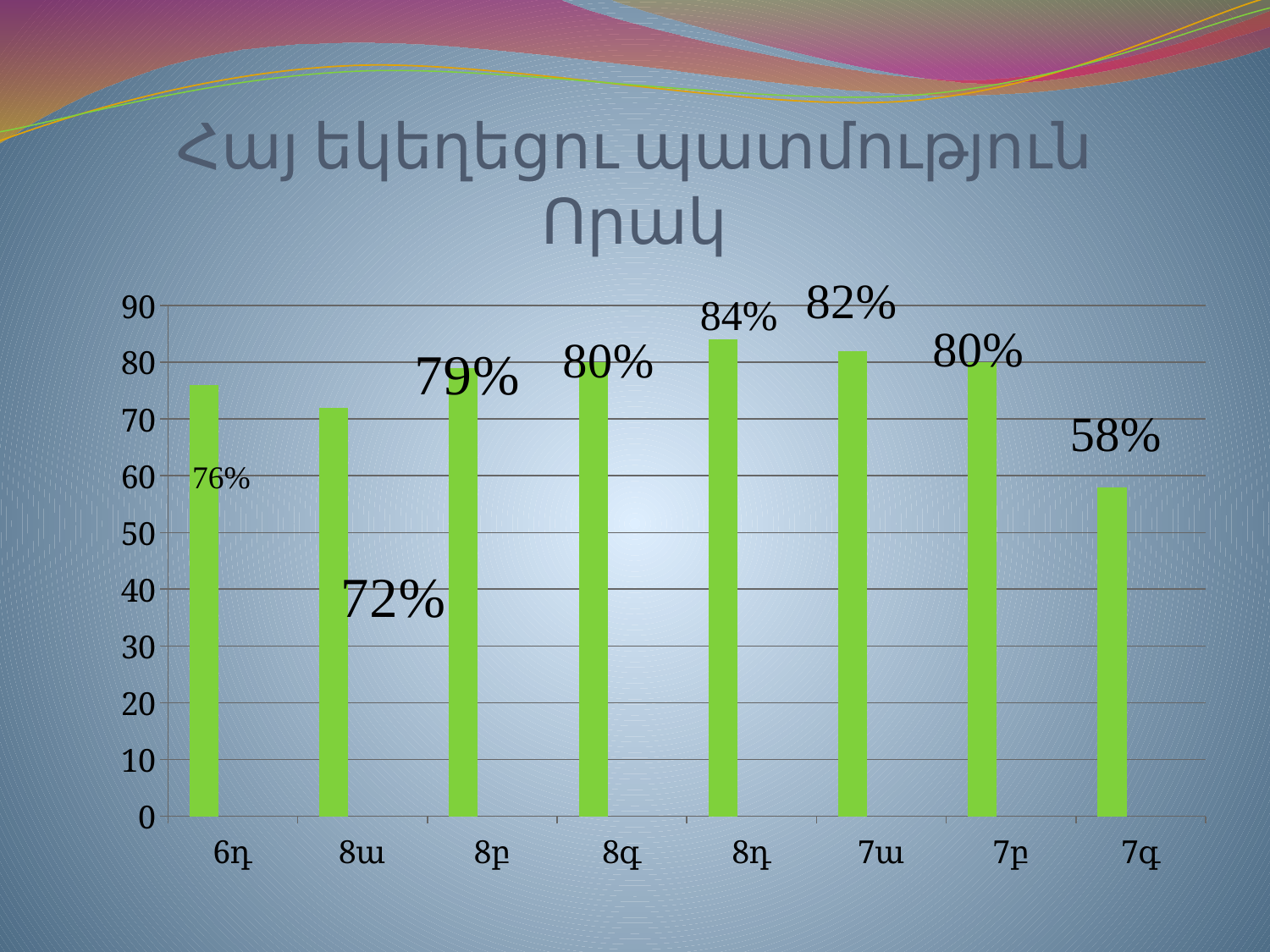
Which category has the highest value? 8դ Which category has the lowest value? 7գ What is the value for 7գ? 58% What is the difference between the values for 8դ and 7գ? 26% What is the difference between the values for 8բ and 8ա? 7% What kind of chart is shown on the slide? Bar chart How many categories are shown on the x axis? 8 What is the title of the slide? Հայ եկեղեցու պատմություն Որակ What is the value for 6դ? 76% What is the value for 8դ? 84% Which is larger, the value for 7ա or the value for 6դ? 7ա What is the value for 8ա? 72%